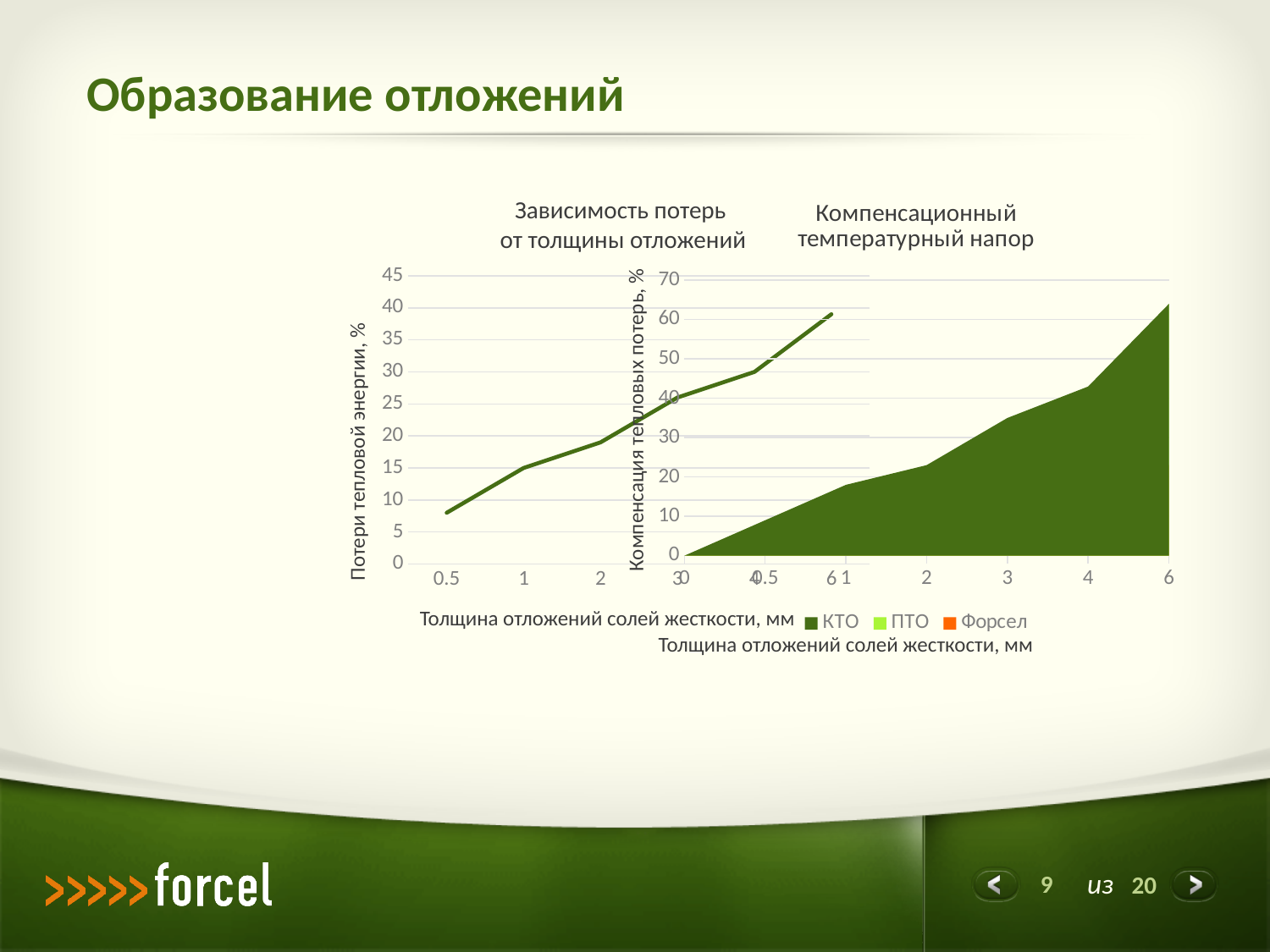
In the left chart 'Зависимость потерь от толщины отложений', is the value at thickness 2 greater or less than 15? greater In the right chart 'Компенсационный температурный напор', is the value at thickness 1 greater or less than 10? greater In the right chart 'Компенсационный температурный напор', is the value at thickness 4 greater or less than 30? greater What is the y-axis label of the left chart 'Зависимость потерь от толщины отложений'? Потери тепловой энергии, % In the right chart 'Компенсационный температурный напор', do the values rise or fall along the x axis? rise How many thickness values are marked on the x axis of the left chart 'Зависимость потерь от толщины отложений'? 6 In the left chart 'Зависимость потерь от толщины отложений', do the values rise or fall as the deposit thickness increases along the x axis? rise How many series does the legend of the right chart 'Компенсационный температурный напор' list? 3 What kind of chart is the right chart, 'Компенсационный температурный напор'? area chart What kind of chart is the left chart, 'Зависимость потерь от толщины отложений'? line chart